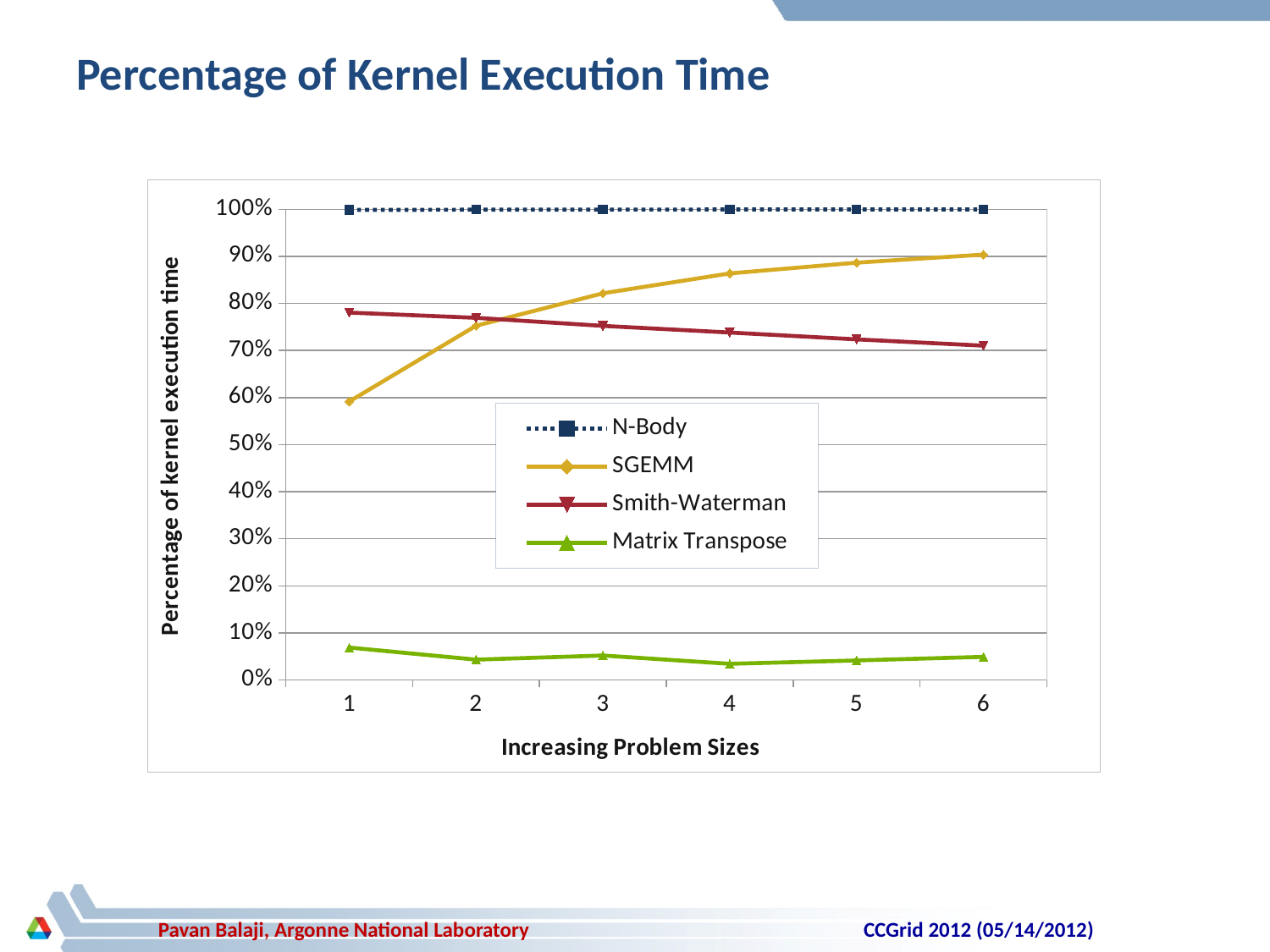
How many problem sizes are plotted along the x axis? 6 Does the SGEMM series rise or fall as problem size increases from 1 to 6? rise What is the label of the x axis? Increasing Problem Sizes How many series does the legend list? 4 Is the value for Matrix Transpose at problem size 4 greater or less than 10%? less What kind of chart is shown on the slide? line chart At problem size 6, which is larger: SGEMM or Smith-Waterman? SGEMM Which series has the lowest values across all problem sizes? Matrix Transpose Does the Smith-Waterman series rise or fall as problem size increases from 1 to 6? fall